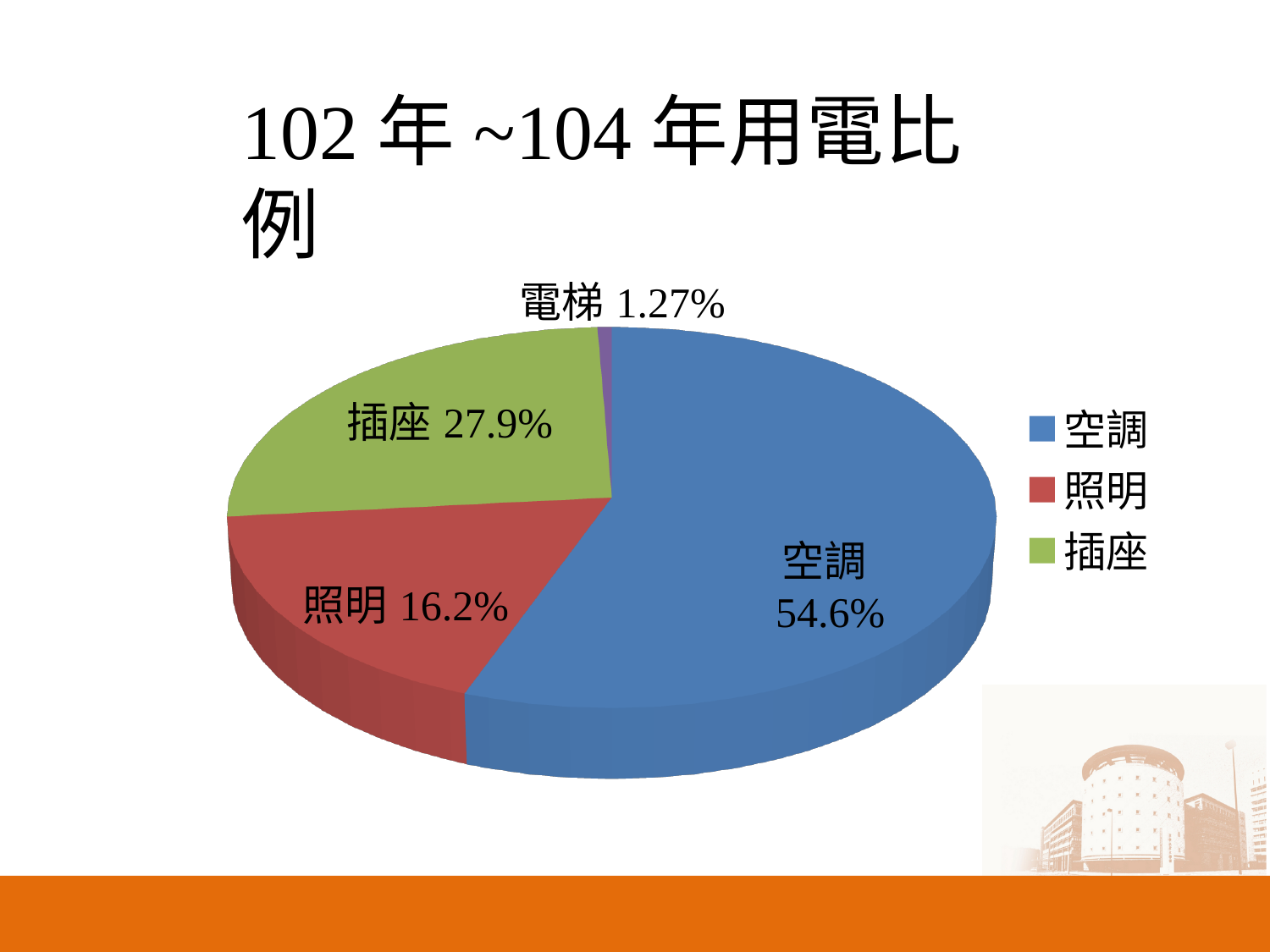
What is the difference in percentage points between 插座 and 照明? 11.7 What percentage is shown for 照明 in the pie chart? 16.2% How many slices does the pie chart have? 4 What colour is the 空調 slice in the pie chart? Blue How many entries does the legend list? 3 Which category has the largest share of electricity use? 空調 What type of chart is shown on the slide? Pie chart What percentage is shown for 插座 in the pie chart? 27.9% Which has a larger share, 照明 or 插座? 插座 What share of electricity use does 空調 account for in the pie chart? 54.6% Which category has the smallest share of electricity use? 電梯 What percentage is shown for 電梯 in the pie chart? 1.27%